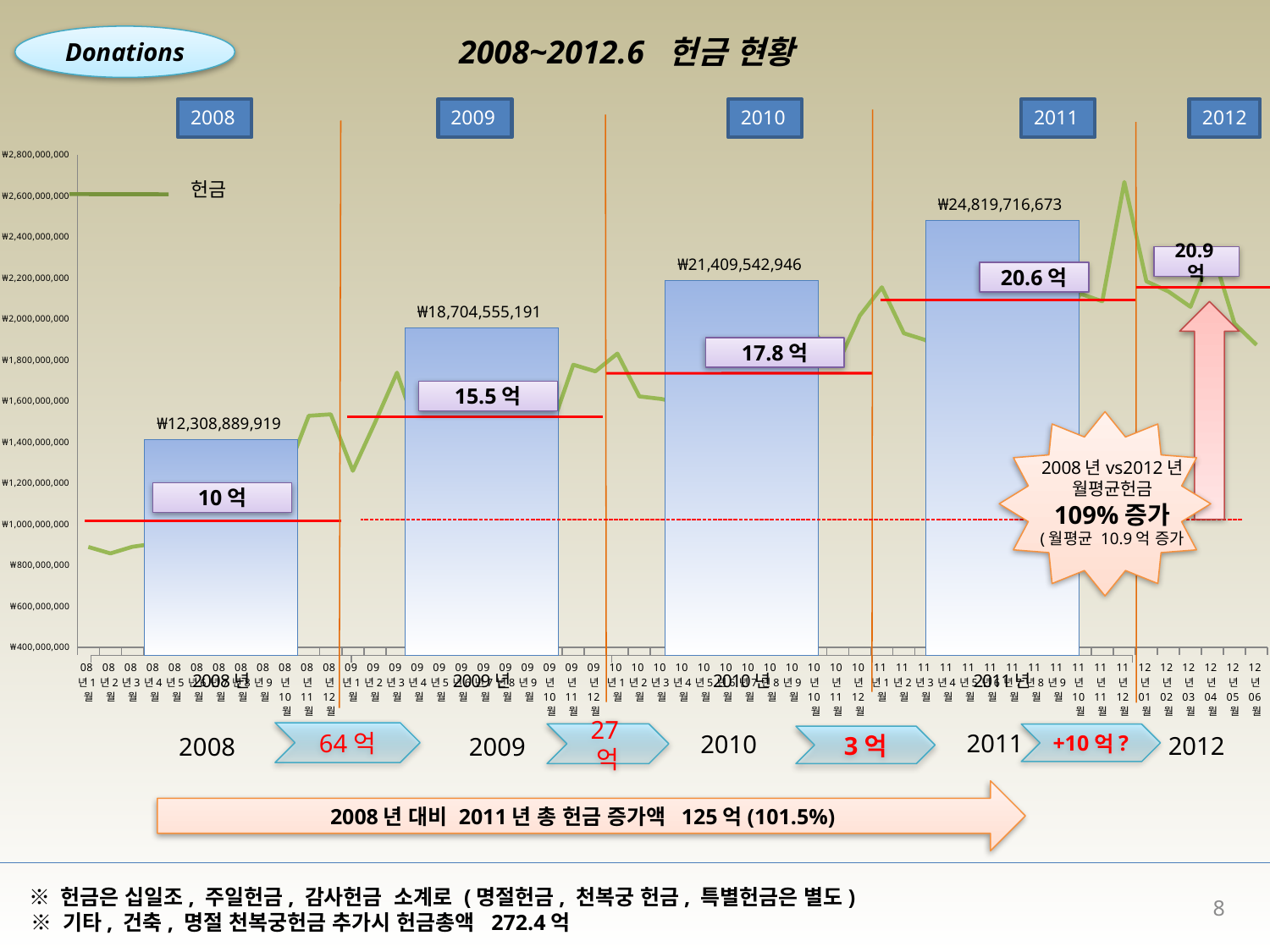
What monthly average donation is labelled for 2010? 17.8 억 Which year has the lowest annual donation bar? 2008 What is the total donation value shown for 2010? ₩21,409,542,946 What monthly average donation is labelled for 2012? 20.9 억 What is the difference between the 2010 and 2009 annual donation totals? ₩2,704,987,755 What is the total donation value shown for 2008? ₩12,308,889,919 Do the annual donation totals rise or fall from 2008 to 2011? rise What is the total donation value shown for 2009? ₩18,704,555,191 How many annual donation bars are plotted on the chart? 4 Which year has the highest annual donation bar? 2011 What is the difference between the 2011 and 2008 annual donation totals? ₩12,510,826,754 What is the total donation value shown for 2011? ₩24,819,716,673